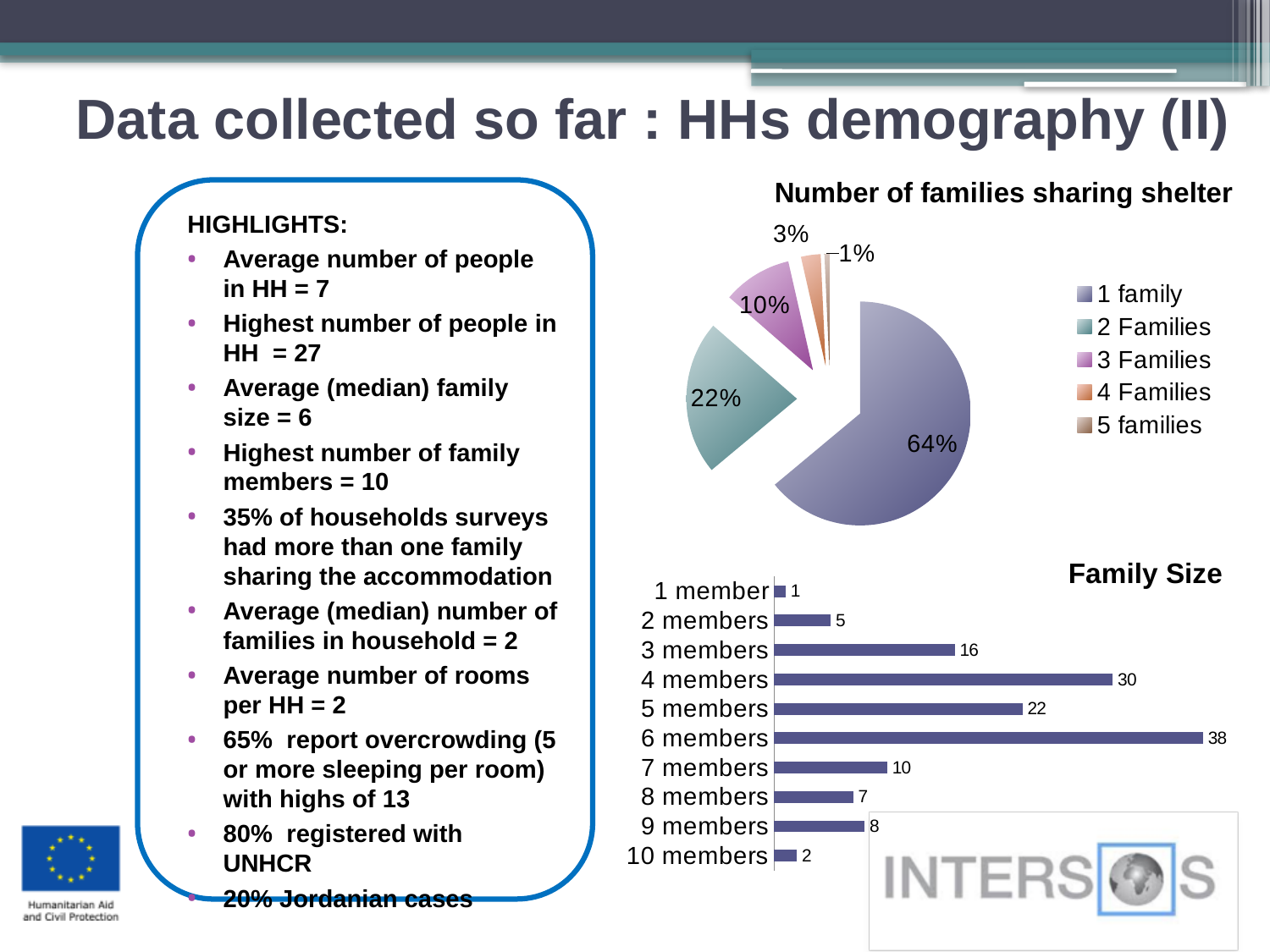
How many categories are shown in the 'Family Size' chart? 10 In the 'Number of families sharing shelter' chart, which category has the smallest slice? 5 families In the 'Number of families sharing shelter' chart, what share of the pie is '2 Families'? 22% What kind of chart is 'Number of families sharing shelter'? Pie chart In the 'Number of families sharing shelter' chart, what share of the pie is '1 family'? 64% In the 'Family Size' chart, which is larger: the value for '3 members' or the value for '5 members'? 5 members In the 'Number of families sharing shelter' chart, how many categories does the legend list? 5 In the 'Family Size' chart, what is the value for '4 members'? 30 In the 'Family Size' chart, which category has the highest value? 6 members In the 'Family Size' chart, what is the value for '6 members'? 38 In the 'Family Size' chart, what is the difference between the values for '6 members' and '4 members'? 8 In the 'Family Size' chart, which category has the lowest value? 1 member